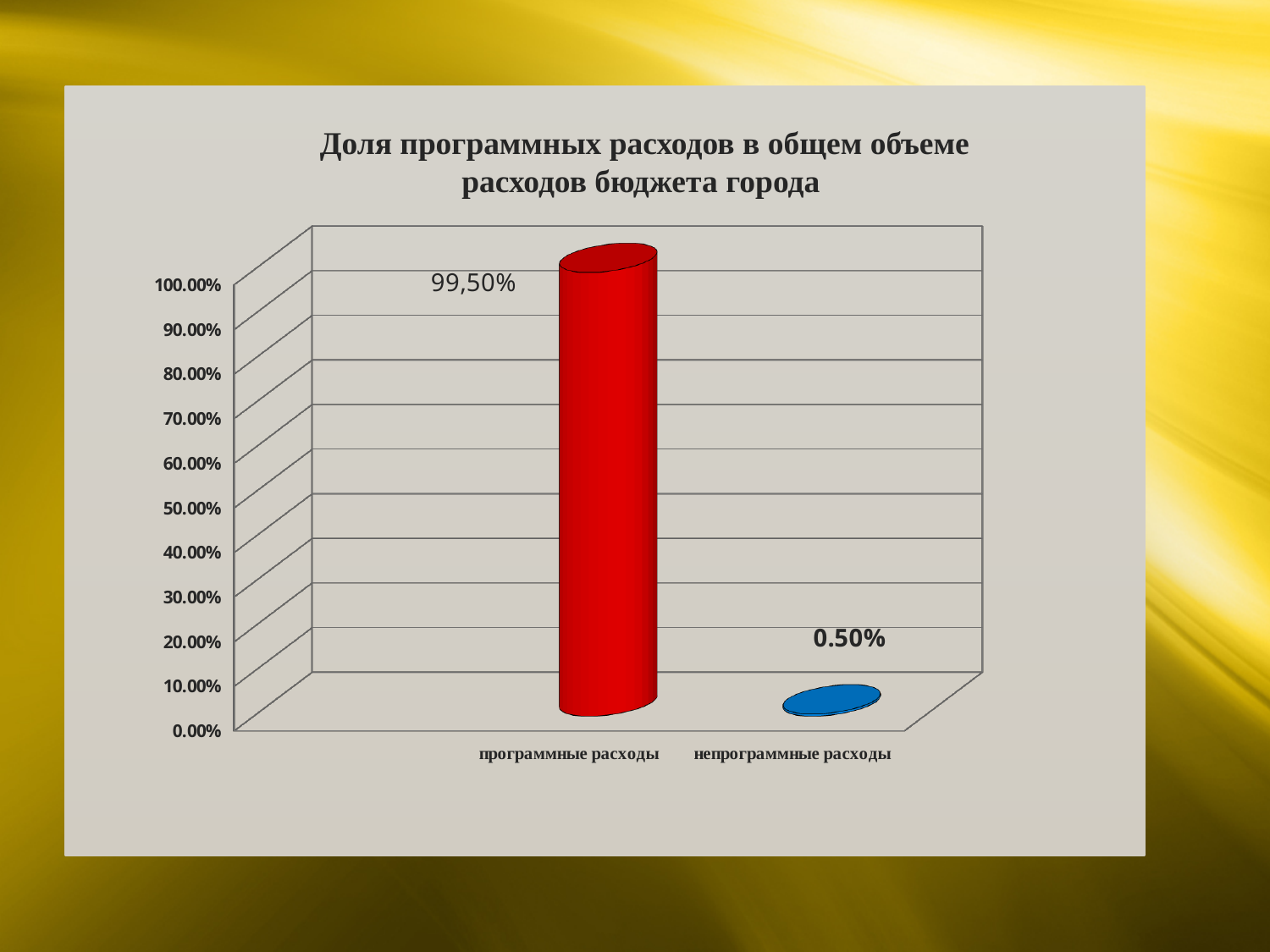
Is the value for программные расходы greater or less than 90.00%? greater What kind of chart is shown on the slide? bar chart What is the title of the chart? Доля программных расходов в общем объеме расходов бюджета города What colour is the bar for программные расходы? red Which is larger: программные расходы or непрограммные расходы? программные расходы Is the value for непрограммные расходы greater or less than 10.00%? less How many categories are shown on the chart? 2 What is the value for непрограммные расходы? 0.50% What is the value for программные расходы? 99,50% What is the highest tick label on the vertical axis? 100.00% Which category has the highest value? программные расходы Which category has the lowest value? непрограммные расходы